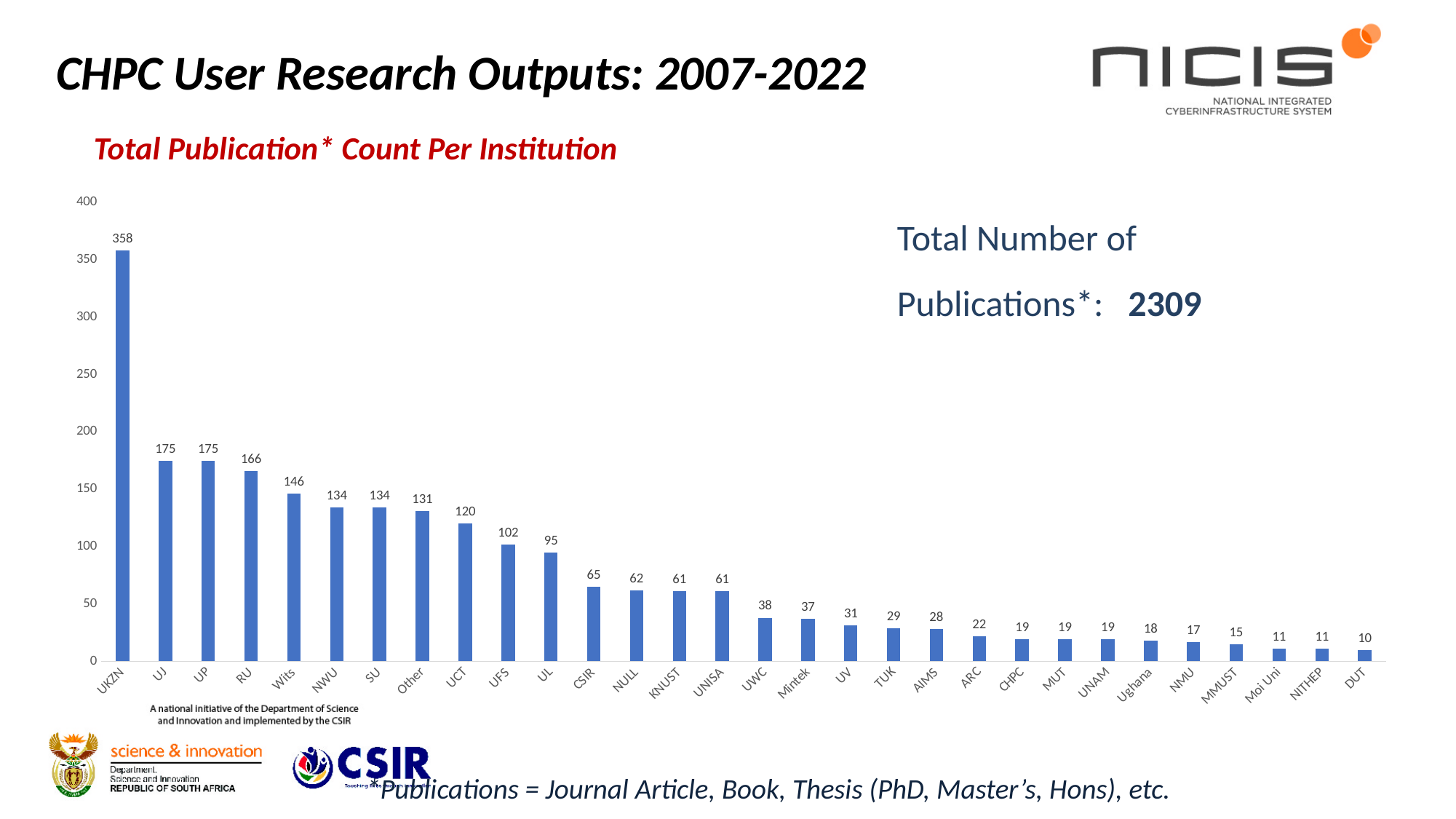
What is the publication count for CSIR? 65 Which institution has the lowest publication count? DUT Which has a higher publication count, RU or NWU? RU What is the publication count for UKZN? 358 What is the difference between the publication counts of UCT and UFS? 18 What kind of chart is shown on the slide? Bar chart Is the value for UL greater or less than 100? less Do the publication counts rise or fall from left to right along the x axis? Fall How many institutions are shown on the x axis? 30 What is the publication count for Wits? 146 What is the difference between the publication counts of UKZN and UJ? 183 Which institution has the highest publication count? UKZN